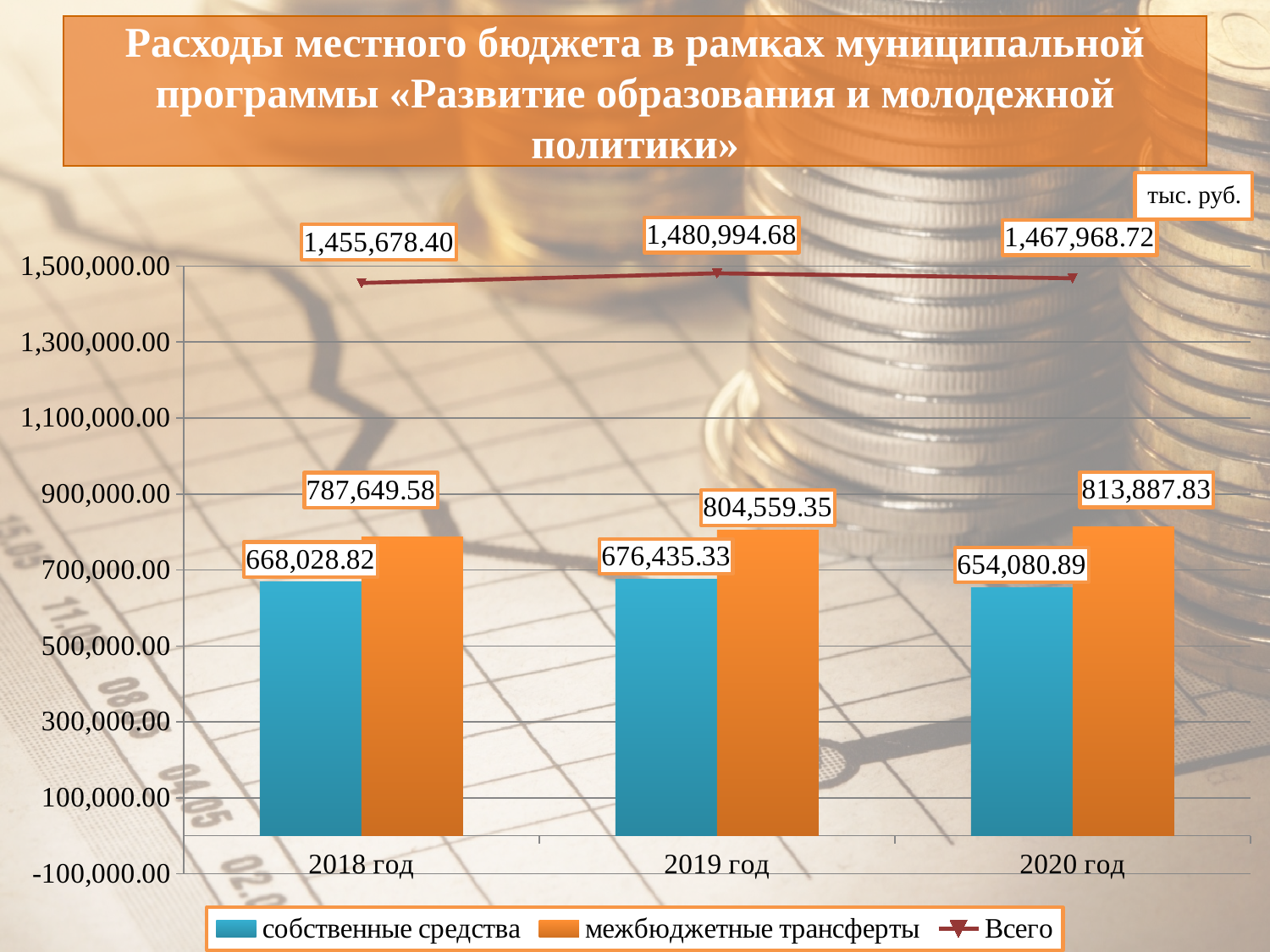
Which is larger: собственные средства in 2019 год or собственные средства in 2020 год? собственные средства in 2019 год What is the difference between межбюджетные трансферты and собственные средства in 2018 год? 119,620.76 What is the value of Всего for 2019 год? 1,480,994.68 In which year is собственные средства lowest? 2020 год What unit is indicated in the top right corner of the chart? тыс. руб. By how much did межбюджетные трансферты in 2020 год exceed the value in 2018 год? 26,238.25 In which year is межбюджетные трансферты highest? 2020 год What is the value for собственные средства in 2018 год? 668,028.82 How many series does the legend list? 3 What is the value for межбюджетные трансферты in 2020 год? 813,887.83 How many years are shown on the x axis? 3 In which year is Всего highest? 2019 год